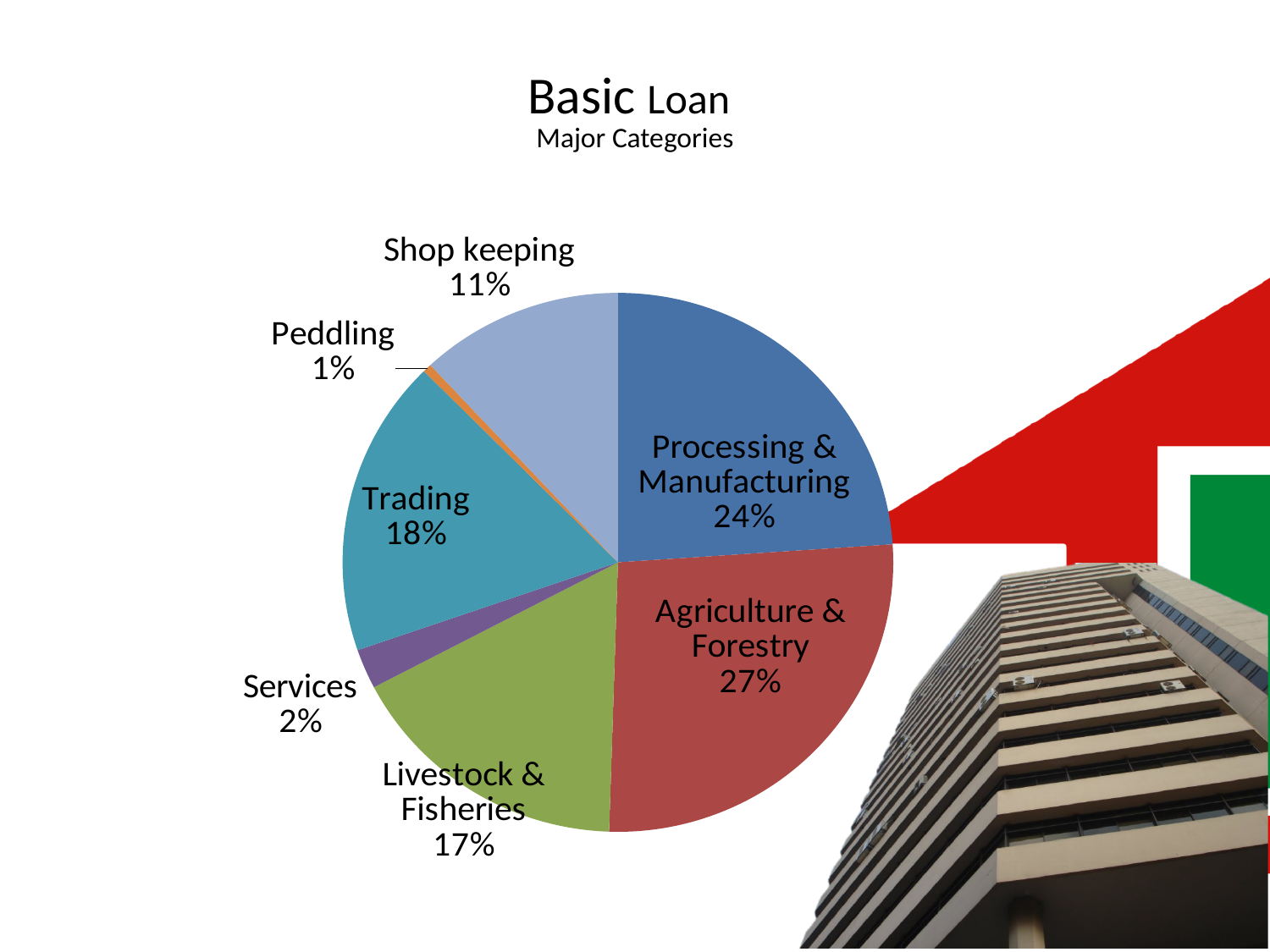
What is the value shown for Services? 2% What is the combined share of Processing & Manufacturing and Agriculture & Forestry? 51% What kind of chart is shown on the slide? Pie chart What share of the pie does Agriculture & Forestry represent? 27% What is the value shown for Shop keeping? 11% Which is larger, the share for Trading or the share for Shop keeping? Trading Which category has the largest slice of the pie? Agriculture & Forestry Which category has the smallest slice of the pie? Peddling What is the value shown for Trading? 18% How many categories are shown in the pie chart? 7 What is the difference between the Processing & Manufacturing share and the Livestock & Fisheries share? 7% What is the title of the chart? Basic Loan Major Categories